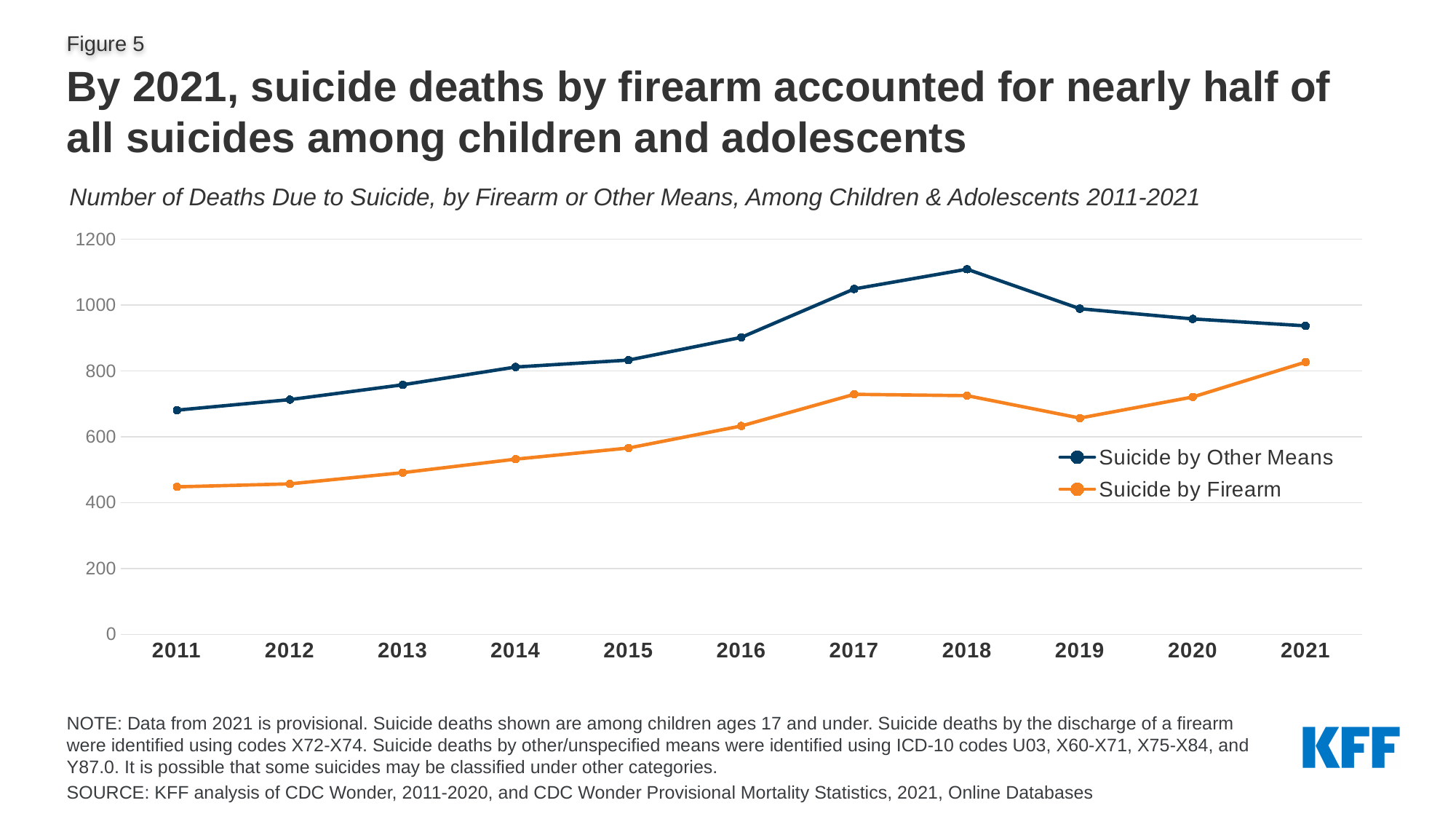
In which year does the Suicide by Firearm series reach its highest value? 2021 Is the value for Suicide by Firearm in 2021 greater or less than 800? greater In 2021, which series has the larger value, Suicide by Other Means or Suicide by Firearm? Suicide by Other Means How many series does the legend list? 2 Is the value for Suicide by Other Means in 2018 greater or less than 1000? greater How many years are plotted along the x axis? 11 Does the Suicide by Firearm series rise or fall from 2011 to 2017? rise Which colour is used for the Suicide by Firearm line? orange In which year is the Suicide by Other Means series at its lowest value? 2011 Is the value for Suicide by Firearm in 2011 greater or less than 600? less What kind of chart is shown on the slide? line chart In which year does the Suicide by Other Means series reach its highest value? 2018